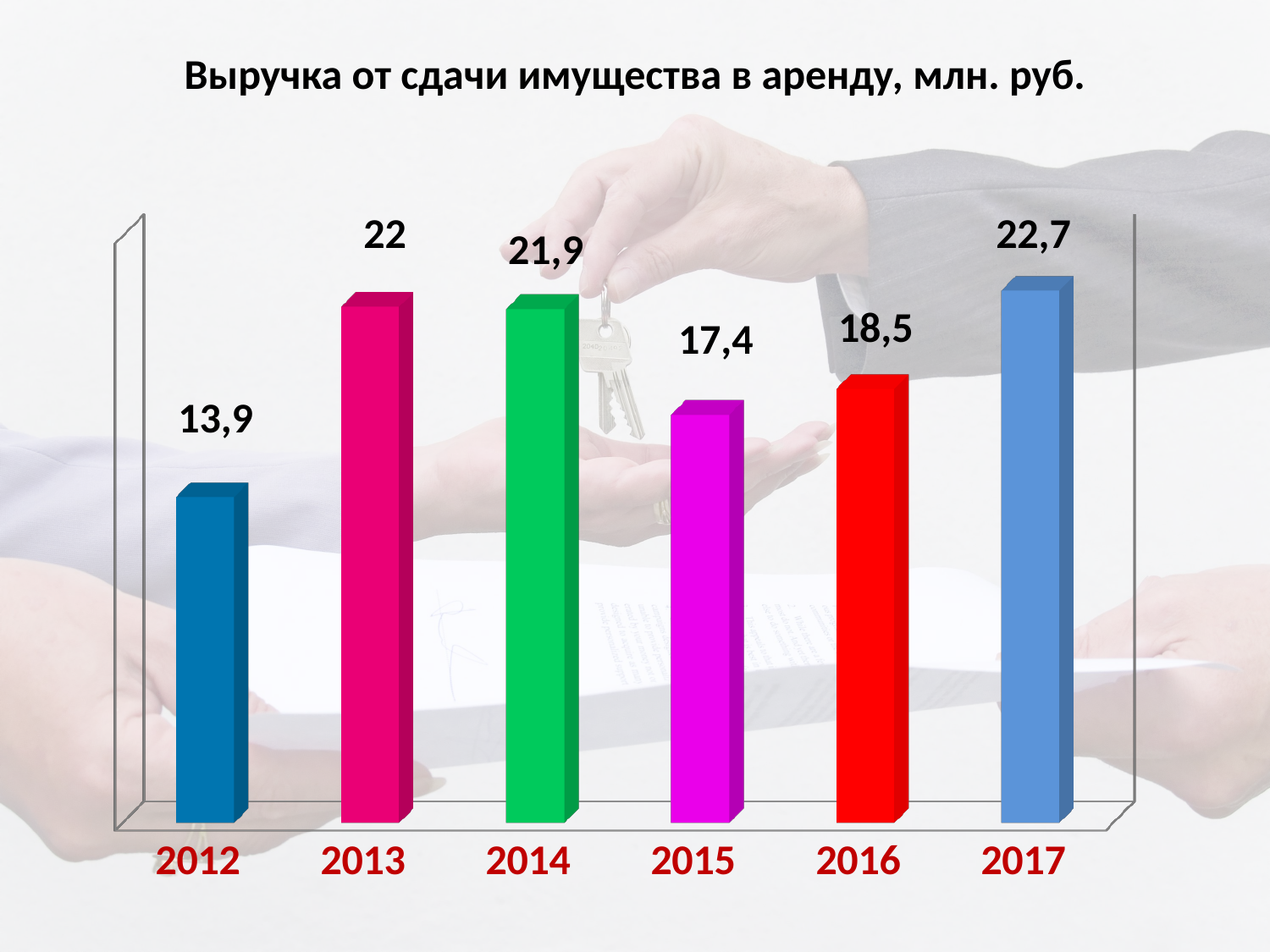
What is the difference between the values for 2017 and 2012? 8,8 Which year has the highest value? 2017 What is the title of the chart? Выручка от сдачи имущества в аренду, млн. руб. What is the value for 2012? 13,9 What is the value for 2017? 22,7 Does the value rise or fall from 2014 to 2015? fall What is the value for 2015? 17,4 How many years are shown on the chart? 6 What kind of chart is shown on the slide? bar chart Which year has the lowest value? 2012 Which is larger, the value for 2016 or the value for 2015? 2016 What is the difference between the values for 2013 and 2015? 4,6